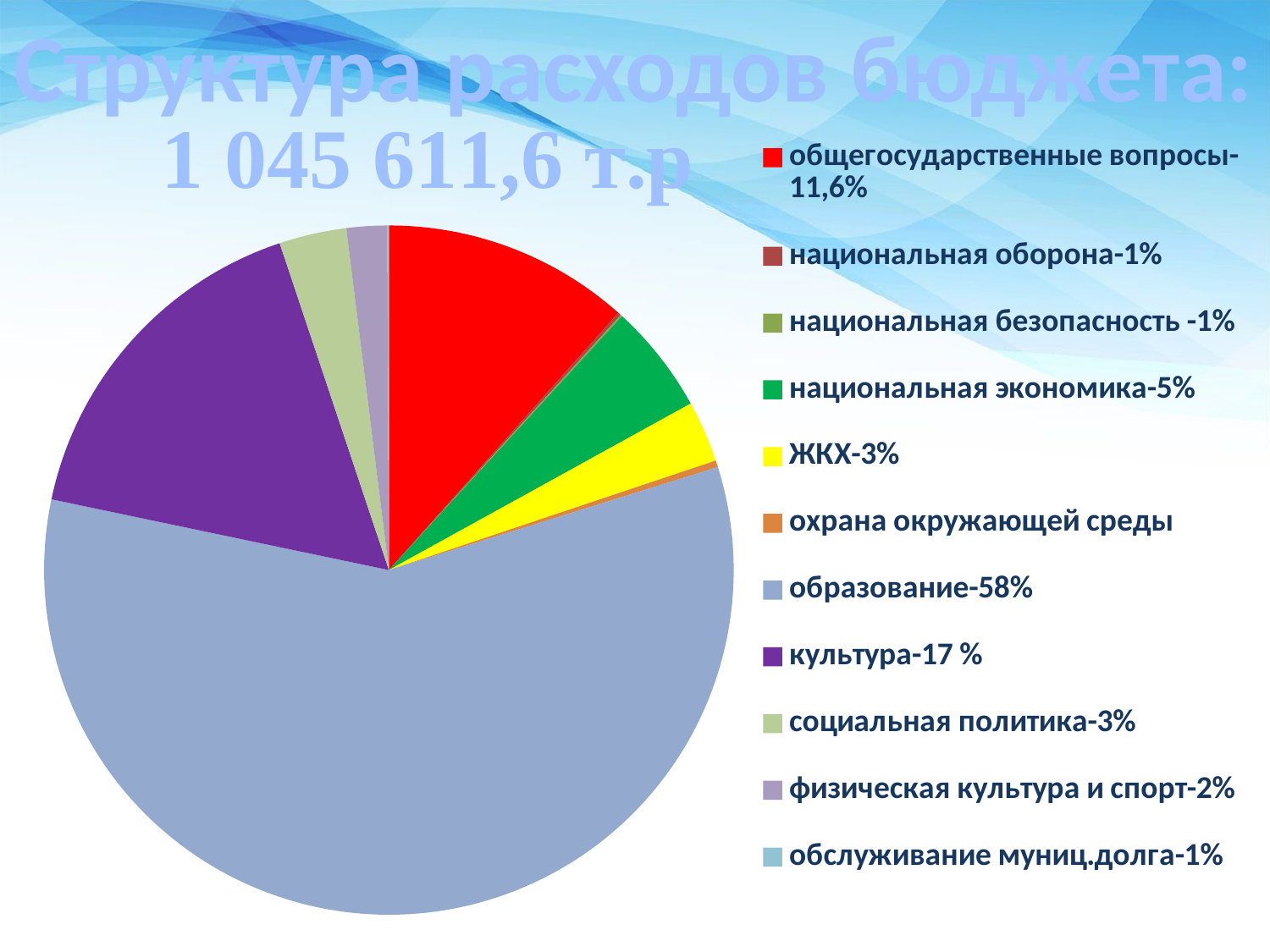
Which category has the largest slice of the pie? образование What share of the budget expenditure goes to образование according to the legend? 58% What kind of chart is shown on the slide? pie chart What share is shown for национальная экономика? 5% Which legend entry has no percentage shown next to it? охрана окружающей среды Which is larger, the share for культура or the share for общегосударственные вопросы? культура What share is shown for физическая культура и спорт? 2% What share is shown for общегосударственные вопросы? 11,6% What total amount is given in the chart title? 1 045 611,6 т.р What is the difference between the share for образование and the share for культура? 41% What share is shown for культура in the legend? 17 % How many categories does the legend of the pie chart list? 11